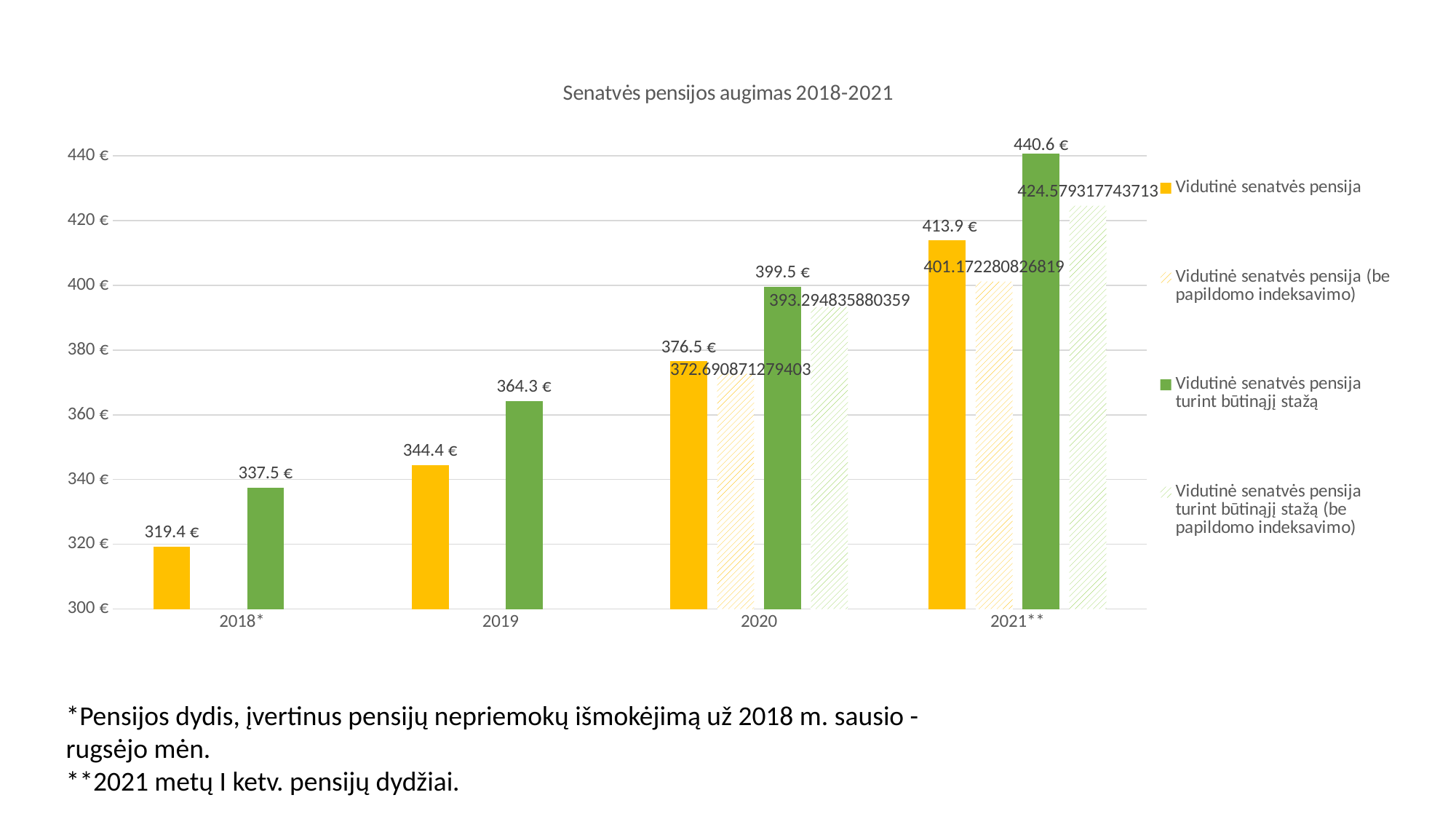
What kind of chart is this? Bar chart What is the value of 'Vidutinė senatvės pensija' for 2019? 344.4 € Which year has the highest value for 'Vidutinė senatvės pensija turint būtinąjį stažą'? 2021** What is the value of 'Vidutinė senatvės pensija turint būtinąjį stažą' for 2021**? 440.6 € Which is larger in 2020: 'Vidutinė senatvės pensija' or 'Vidutinė senatvės pensija turint būtinąjį stažą'? Vidutinė senatvės pensija turint būtinąjį stažą What is the value of 'Vidutinė senatvės pensija (be papildomo indeksavimo)' for 2020? 372.690871279403 Which year has the lowest value for 'Vidutinė senatvės pensija'? 2018* How many series does the legend list? 4 How many year categories are shown on the x axis? 4 What is the value of 'Vidutinė senatvės pensija turint būtinąjį stažą (be papildomo indeksavimo)' for 2021**? 424.579317743713 What is the difference between 'Vidutinė senatvės pensija turint būtinąjį stažą' and 'Vidutinė senatvės pensija' in 2018*? 18.1 € Does the value of 'Vidutinė senatvės pensija' rise or fall from 2018* to 2021**? Rise